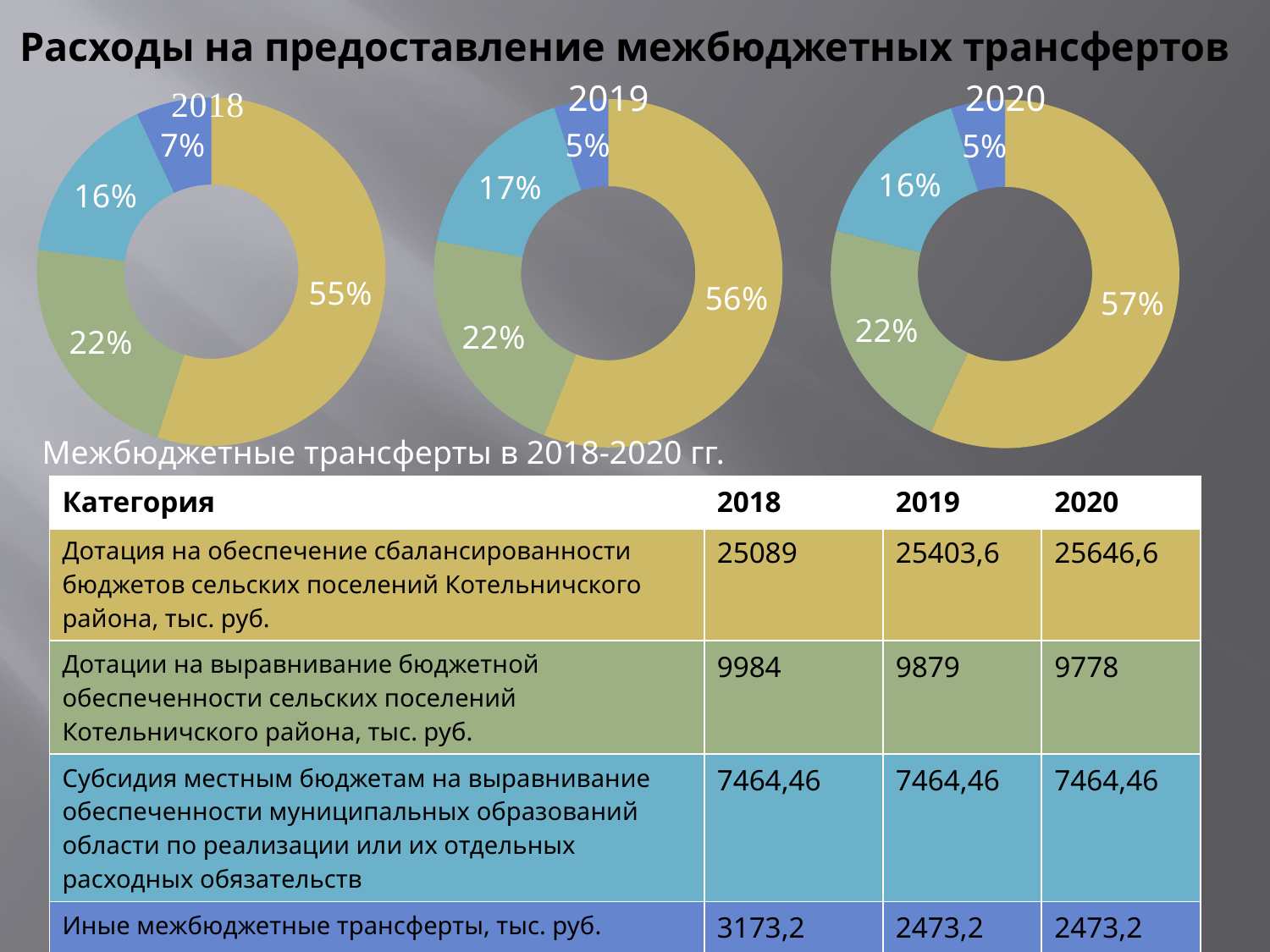
In the 2020 pie chart, what share does the smallest (dark blue) slice have? 5% In the 2018 pie chart, what share does the smallest (dark blue) slice have? 7% Which is larger: the dark blue slice in the 2018 pie chart or the dark blue slice in the 2019 pie chart? 2018 In the 2019 pie chart, what share does the largest (yellow) slice have? 56% In the 2019 pie chart, what share does the light blue slice have? 17% In the 2018 pie chart, what share does the largest (yellow) slice have? 55% What is the difference between the yellow slice share in the 2020 pie chart and the yellow slice share in the 2018 pie chart? 2% In the 2018 pie chart, what share does the green slice have? 22% In the 2020 pie chart, what share does the largest (yellow) slice have? 57% How many pie charts are shown on the slide? 3 How many slices does each pie chart on the slide have? 4 What kind of chart is used for the 2018, 2019 and 2020 data on the slide? Pie chart (donut)